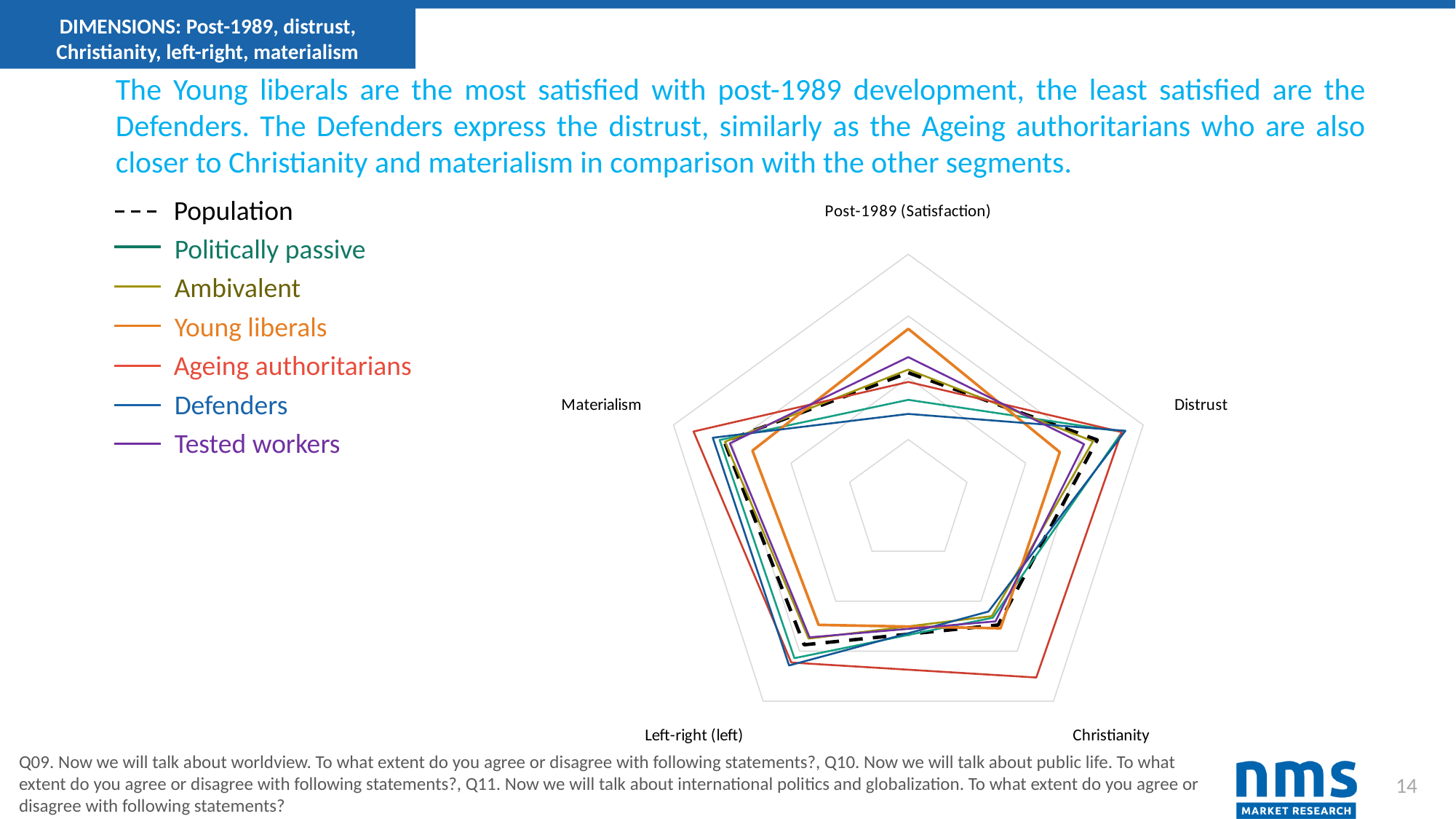
On the Christianity axis, which is larger: Ageing authoritarians or Young liberals? Ageing authoritarians On the Post-1989 (Satisfaction) axis, which is larger: Young liberals or Defenders? Young liberals What kind of chart is shown on the slide? Radar chart Which segment has the lowest value on the Materialism axis? Young liberals Which segment has the lowest value on the Post-1989 (Satisfaction) axis? Defenders Which series is drawn with a dashed line in the legend? Population Which segment has the lowest value on the Distrust axis? Young liberals How many series does the legend list? 7 How many dimensions (axes) does the radar chart have? 5 Which segment has the highest value on the Materialism axis? Ageing authoritarians Which segment has the highest value on the Post-1989 (Satisfaction) axis? Young liberals Which segment has the highest value on the Christianity axis? Ageing authoritarians